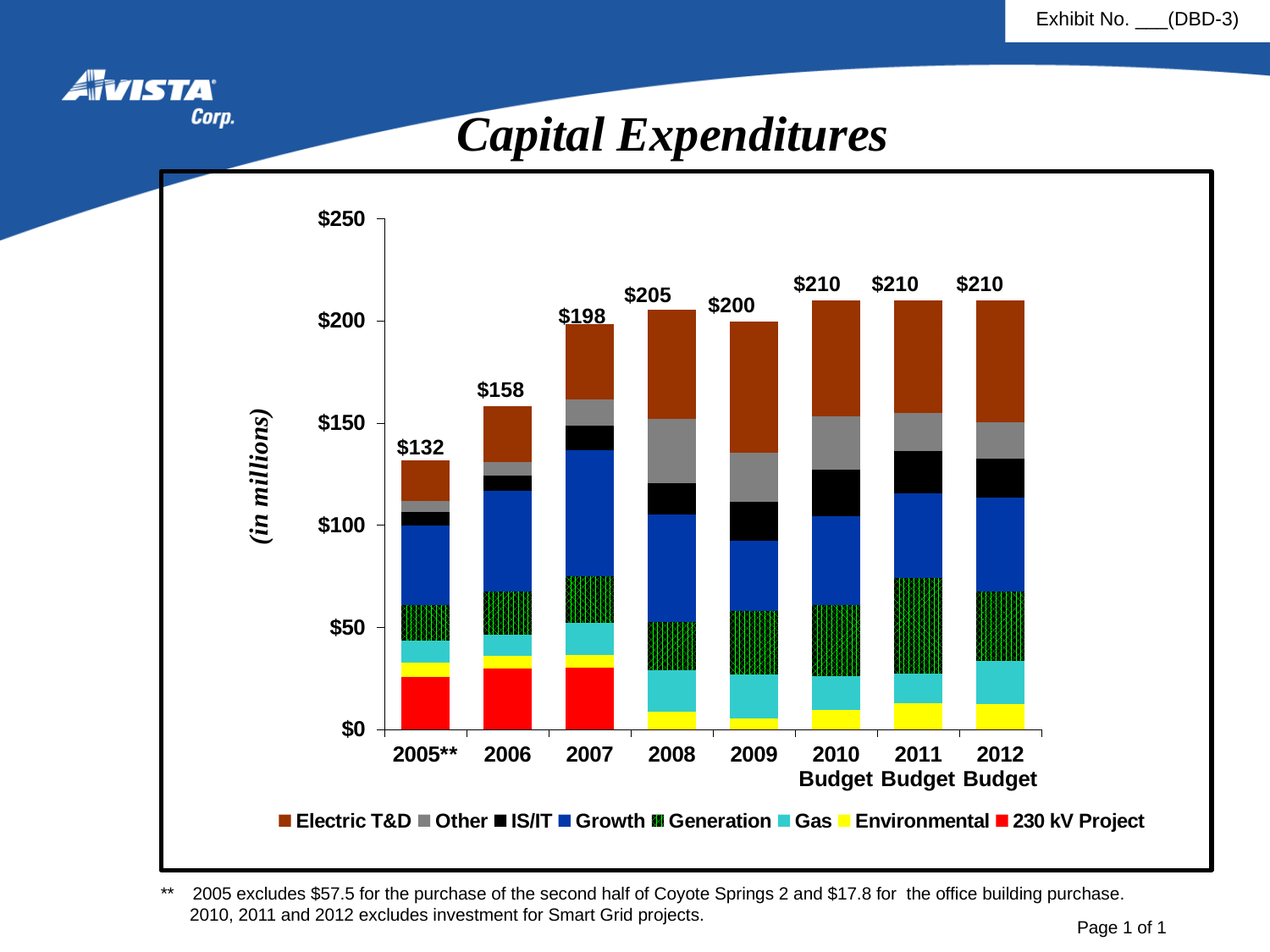
Is the 230 kV Project value for 2005** greater or less than $50? less Which year has the lowest total capital expenditure? 2005** How many series does the legend list? 8 What is the difference between the total for 2010 Budget and the total for 2009? $10 What kind of chart is shown on the slide? Stacked bar chart What is the total capital expenditure shown for 2005**? $132 Do the total capital expenditures rise or fall from 2005** to 2008? Rise What is the total capital expenditure shown for 2007? $198 Which is larger, the total for 2008 or the total for 2009? 2008 How many years are shown on the x axis? 8 What is the total capital expenditure shown for 2011 Budget? $210 What is the difference between the total for 2006 and the total for 2005**? $26